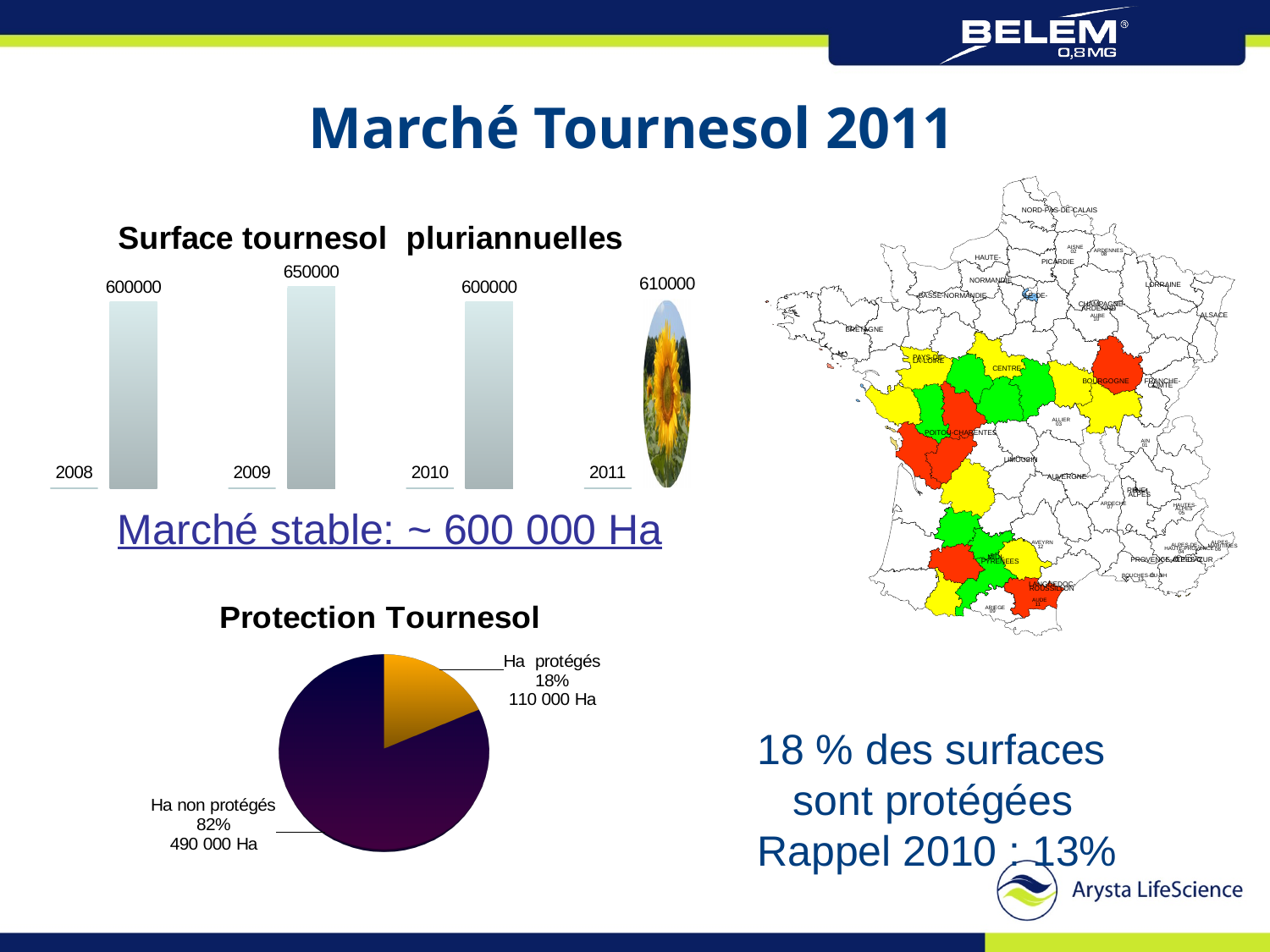
In the 'Surface tournesol pluriannuelles' chart, what is the value for 2009? 650000 In the 'Surface tournesol pluriannuelles' chart, which is larger, the value for 2011 or the value for 2010? 2011 In the 'Surface tournesol pluriannuelles' chart, what is the difference between the 2009 and 2010 values? 50000 In the 'Protection Tournesol' pie chart, how many hectares are 'Ha non protégés'? 490 000 Ha In the 'Surface tournesol pluriannuelles' chart, what is the value for 2011? 610000 How many years are shown in the 'Surface tournesol pluriannuelles' chart? 4 What kind of chart is 'Protection Tournesol'? pie chart In the 'Protection Tournesol' pie chart, which slice is the largest? Ha non protégés In the 'Protection Tournesol' pie chart, what share is 'Ha protégés'? 18% In the 'Surface tournesol pluriannuelles' chart, which year has the highest value? 2009 How many slices does the 'Protection Tournesol' pie chart have? 2 What kind of chart is 'Surface tournesol pluriannuelles'? bar chart